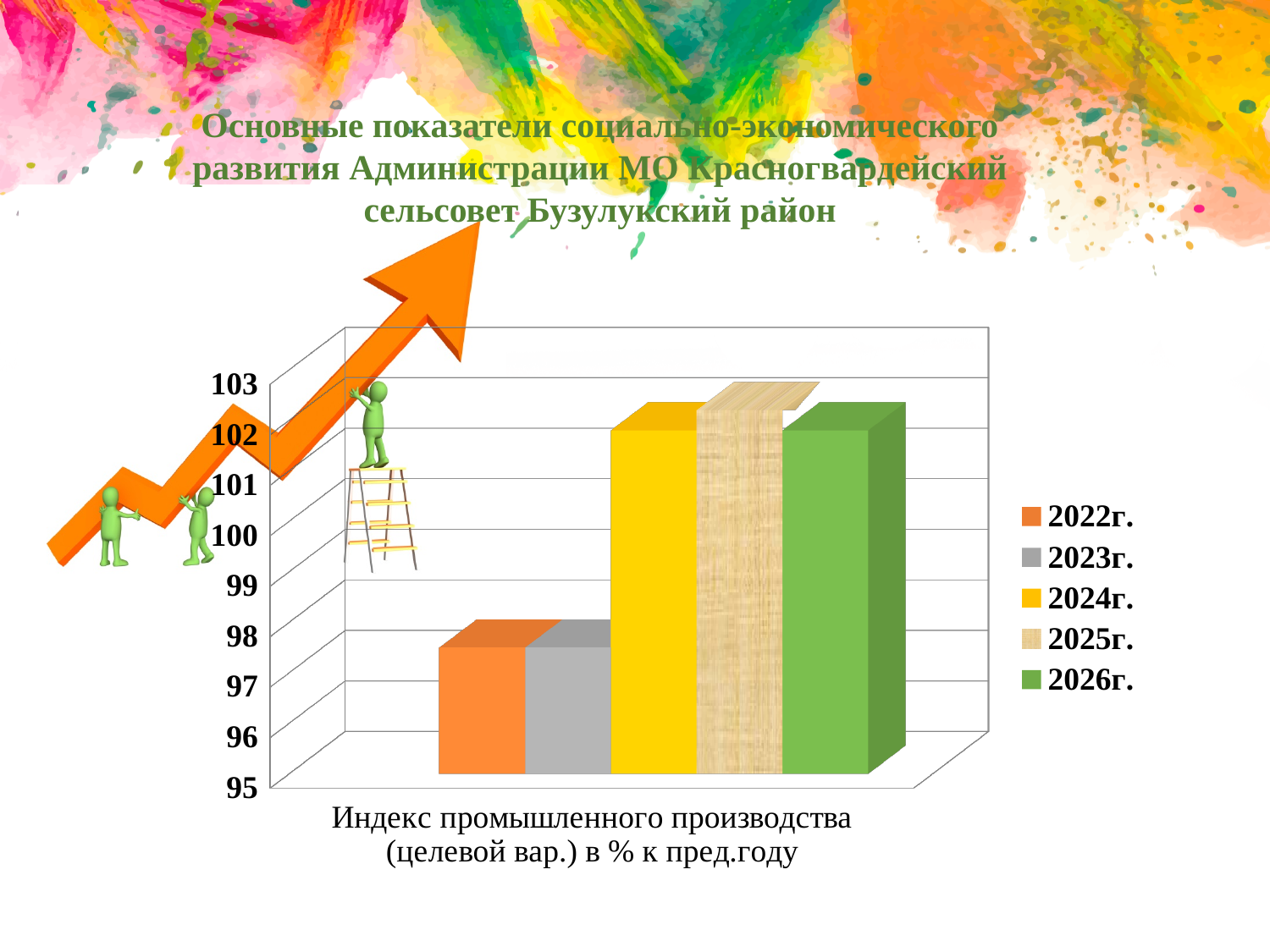
Is the value for 2023г. greater or less than 100? less Which is larger, the value for 2023г. or the value for 2025г.? 2025г. Is the value for 2022г. greater or less than 100? less How many categories are shown on the x axis? 1 Which is larger, the value for 2022г. or the value for 2024г.? 2024г. Is the value for 2024г. greater or less than 100? greater Which is larger, the value for 2026г. or the value for 2022г.? 2026г. How many series does the legend list? 5 What kind of chart is shown on the slide? bar chart Which series is shown in yellow in the legend? 2024г. What is the label of the category on the x axis? Индекс промышленного производства (целевой вар.) в % к пред.году